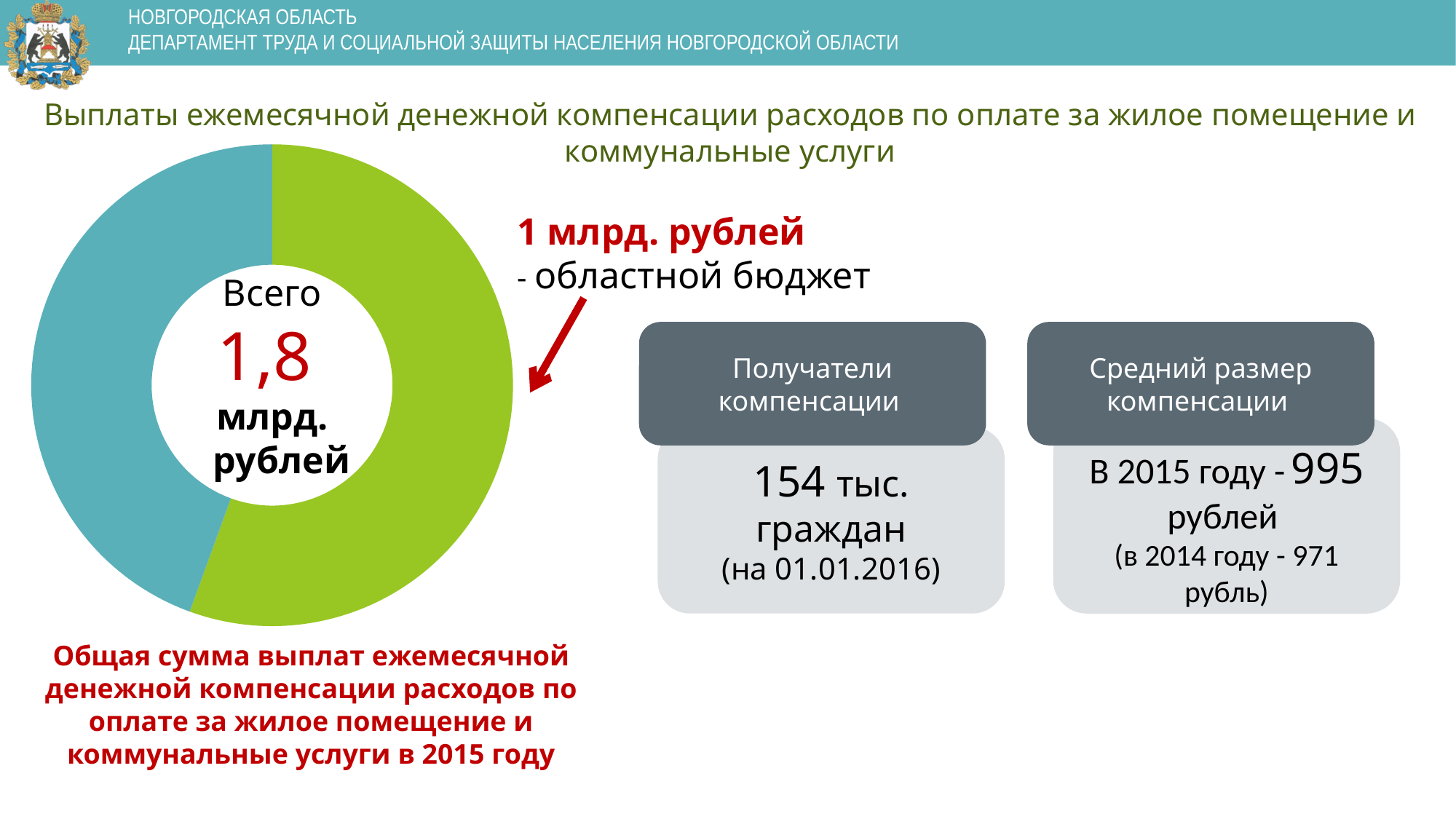
Is the green slice (областной бюджет) larger or smaller than the blue slice? Larger How many slices does the doughnut chart have? 2 What kind of chart is shown on the slide? Doughnut (pie) chart Is the областной бюджет slice greater or less than half of the doughnut chart? greater Which slice of the doughnut chart is the smallest? The blue slice What value is given for the областной бюджет slice of the doughnut chart? 1 млрд. рублей Which slice of the doughnut chart is the largest? Областной бюджет (green slice) What word appears above the total value in the centre of the doughnut chart? Всего What total value is shown in the centre of the doughnut chart? 1,8 млрд. рублей What colour is the областной бюджет slice of the doughnut chart? Green Given the total of 1,8 млрд. рублей and 1 млрд. рублей from the областной бюджет, how much of the total is not from the областной бюджет? 0,8 млрд. рублей